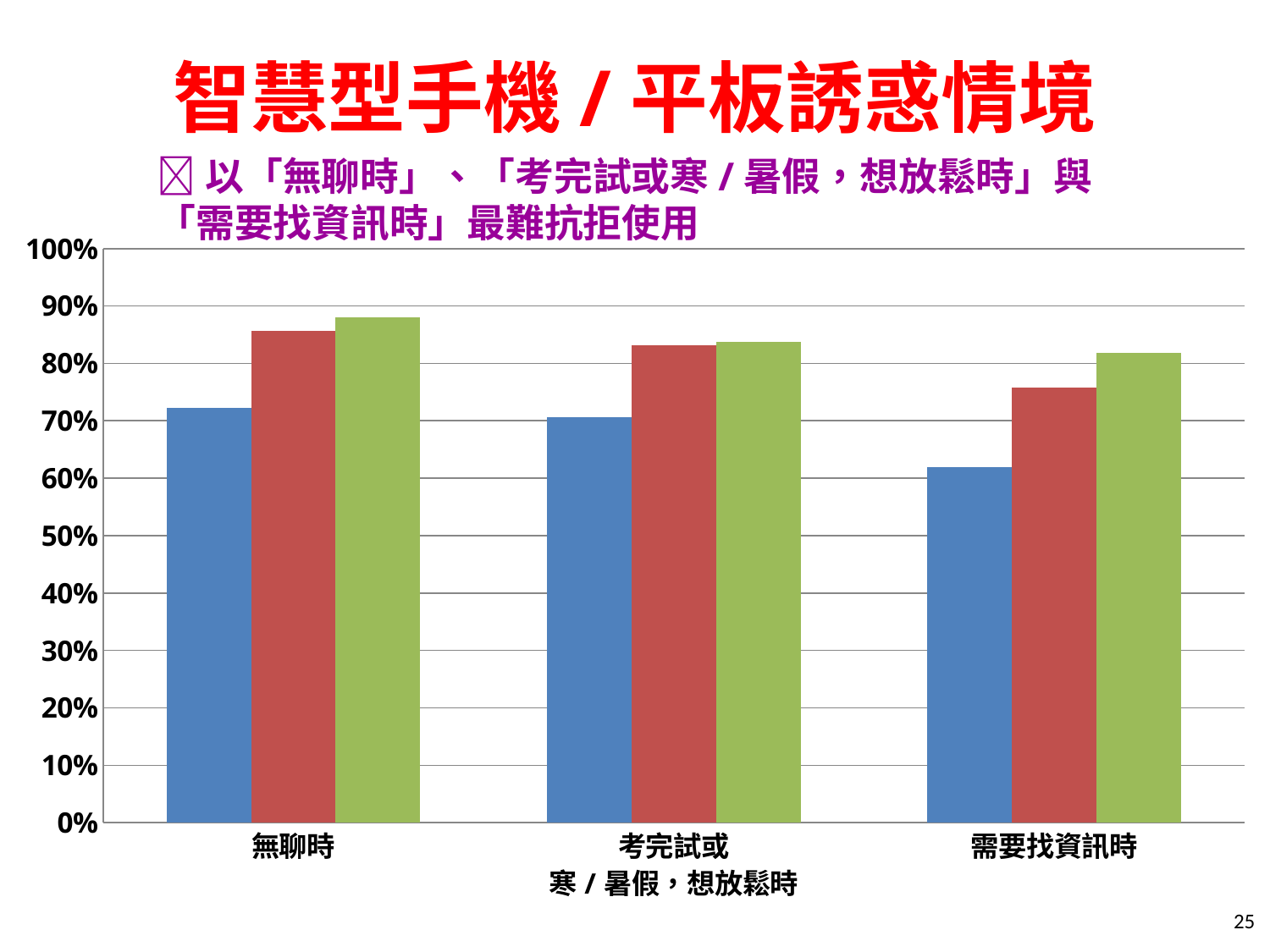
Is the value of the blue bar for 需要找資訊時 greater or less than 60%? greater Is the value of the blue bar for 需要找資訊時 greater or less than 70%? less How many categories are shown along the x axis of the chart? 3 Is the value of the red bar for 需要找資訊時 greater or less than 80%? less Do the blue bars rise or fall moving from left to right across the categories? fall How many bars are plotted for each category in the chart? 3 For which category is the blue bar lowest? 需要找資訊時 What kind of chart is shown on the slide? bar chart For which category is the red bar lowest? 需要找資訊時 In the 需要找資訊時 category, which is larger: the blue bar or the green bar? the green bar